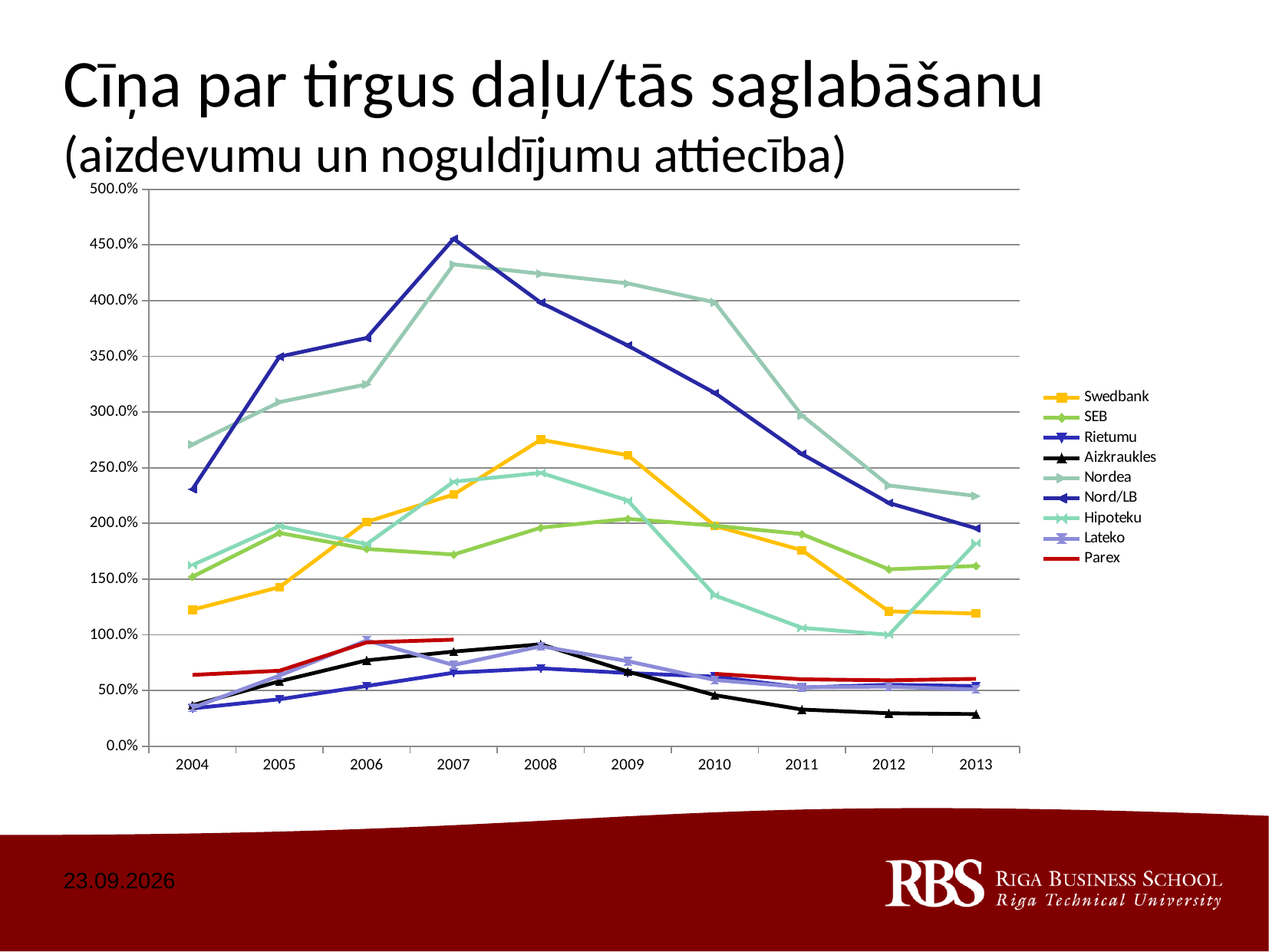
Which series has the highest value in 2007? Nord/LB Is the value for Aizkraukles in 2013 greater or less than 50.0%? less Is the value for Nord/LB in 2007 greater or less than 400.0%? greater Which series has the highest value in 2010? Nordea Is the value for Swedbank in 2008 greater or less than 250.0%? greater How many years are shown on the x axis? 10 What kind of chart is shown on the slide? line chart How many series does the legend list? 9 Which series has the lowest value in 2013? Aizkraukles Does the Nord/LB line rise or fall from 2007 to 2013? fall What colour is the Parex line in the legend? red Which is larger in 2013, the value for Swedbank or the value for SEB? SEB